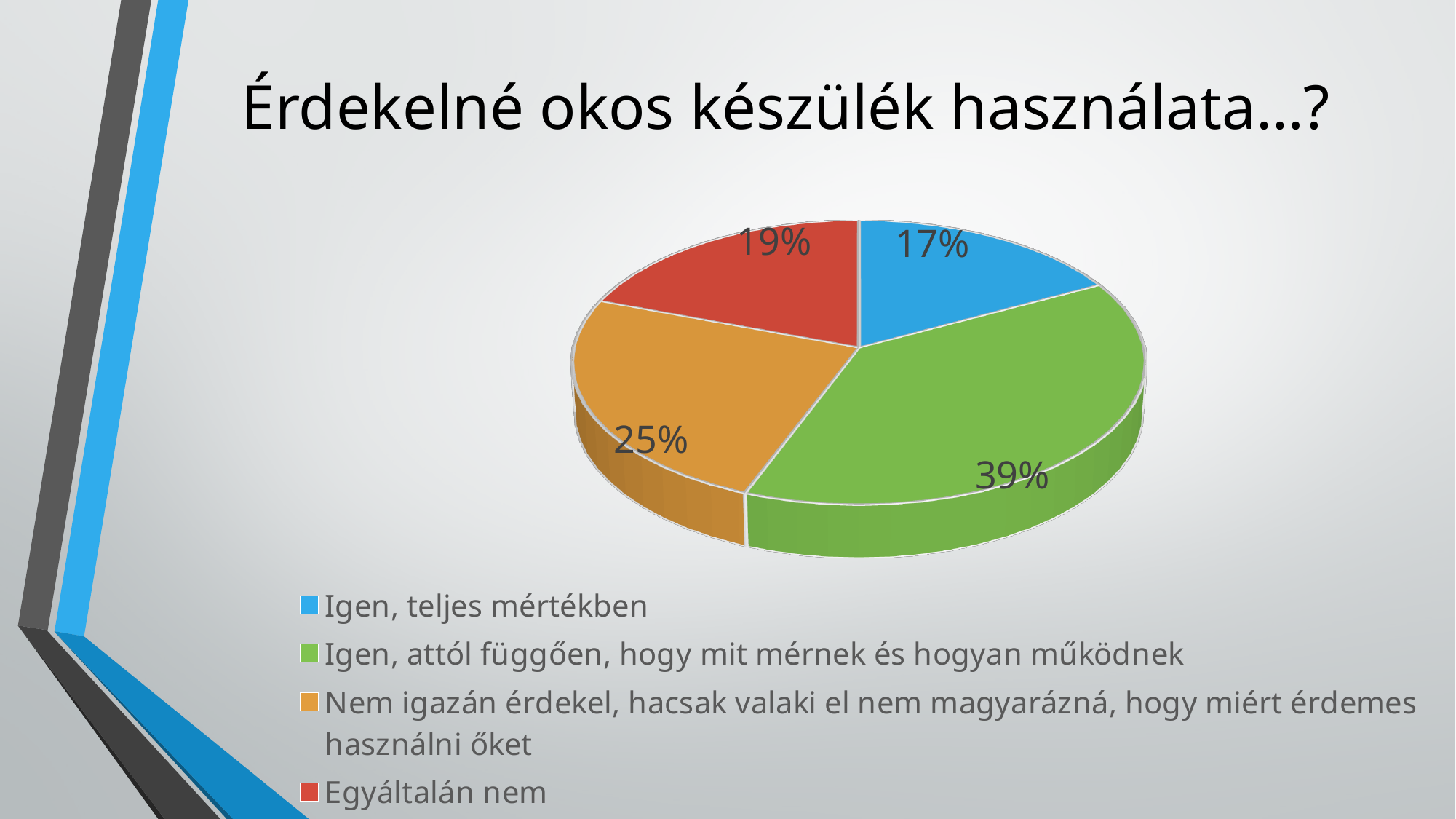
What percentage is shown for "Nem igazán érdekel, hacsak valaki el nem magyarázná, hogy miért érdemes használni őket"? 25% What colour is the slice for "Egyáltalán nem"? red Which is larger: the share for "Egyáltalán nem" or the share for "Nem igazán érdekel, hacsak valaki el nem magyarázná, hogy miért érdemes használni őket"? Nem igazán érdekel, hacsak valaki el nem magyarázná, hogy miért érdemes használni őket How many categories does the pie chart have? 4 What kind of chart is shown on the slide? pie chart Which category has the largest share of the pie? Igen, attól függően, hogy mit mérnek és hogyan működnek What is the difference in percentage points between "Igen, attól függően, hogy mit mérnek és hogyan működnek" and "Igen, teljes mértékben"? 22 What is the title of the chart? Érdekelné okos készülék használata...? What percentage is shown for "Igen, teljes mértékben"? 17% What percentage is shown for "Egyáltalán nem"? 19% What percentage is shown for "Igen, attól függően, hogy mit mérnek és hogyan működnek"? 39% Which category has the smallest share of the pie? Igen, teljes mértékben